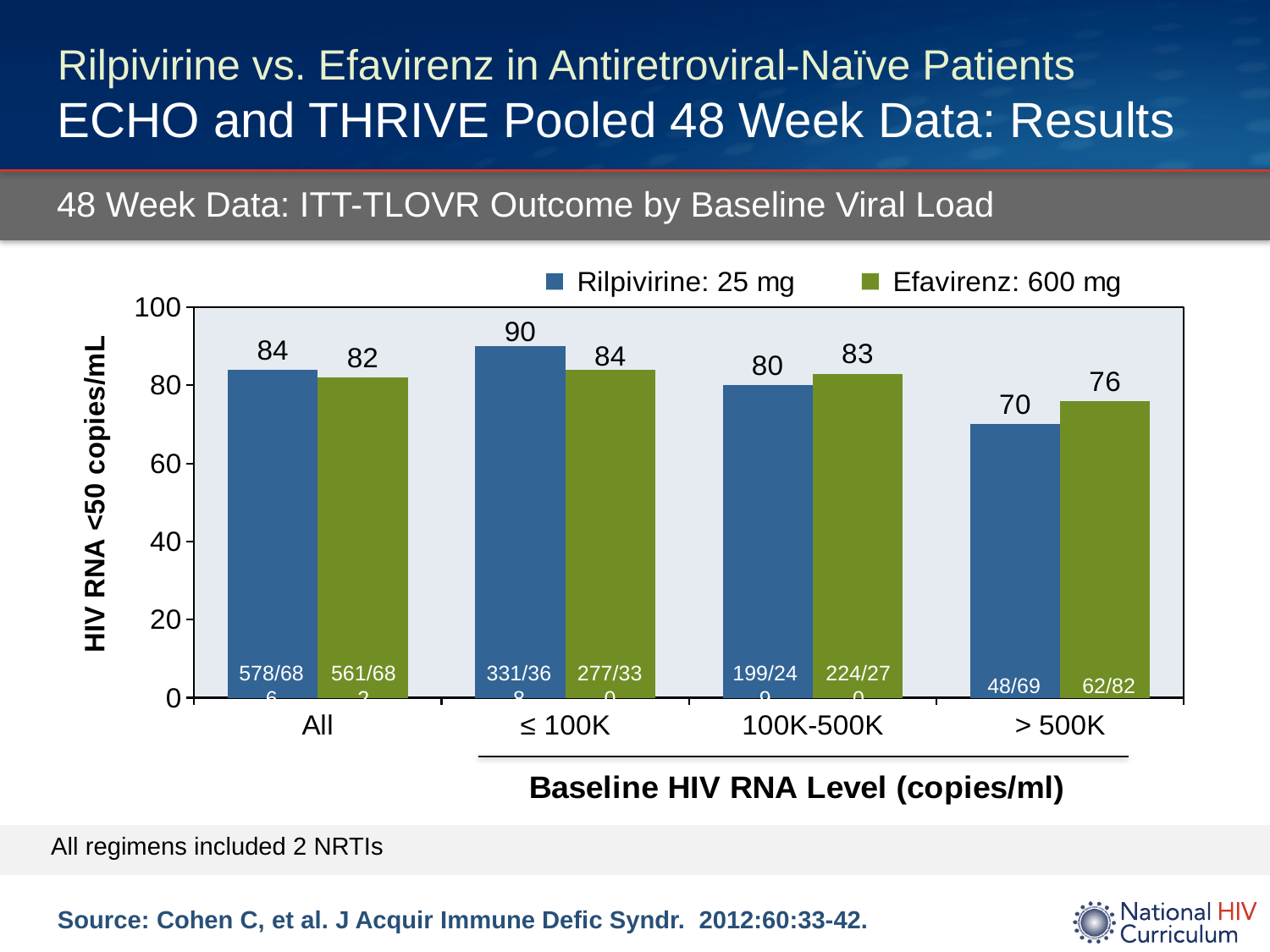
Which category has the lowest value for Efavirenz: 600 mg? > 500K How many series does the legend list? 2 What is the label of the y axis? HIV RNA <50 copies/mL Which category has the highest value for Rilpivirine: 25 mg? ≤ 100K What is the difference between the Rilpivirine: 25 mg and Efavirenz: 600 mg values in the ≤ 100K category? 6 What is the value for Rilpivirine: 25 mg in the ≤ 100K category? 90 In the > 500K category, which series has the larger value, Rilpivirine: 25 mg or Efavirenz: 600 mg? Efavirenz: 600 mg How many baseline HIV RNA level categories are shown on the x axis? 4 What is the value for Rilpivirine: 25 mg in the All category? 84 What is the value for Efavirenz: 600 mg in the > 500K category? 76 What is the value for Efavirenz: 600 mg in the 100K-500K category? 83 What kind of chart is shown on the slide? Bar chart